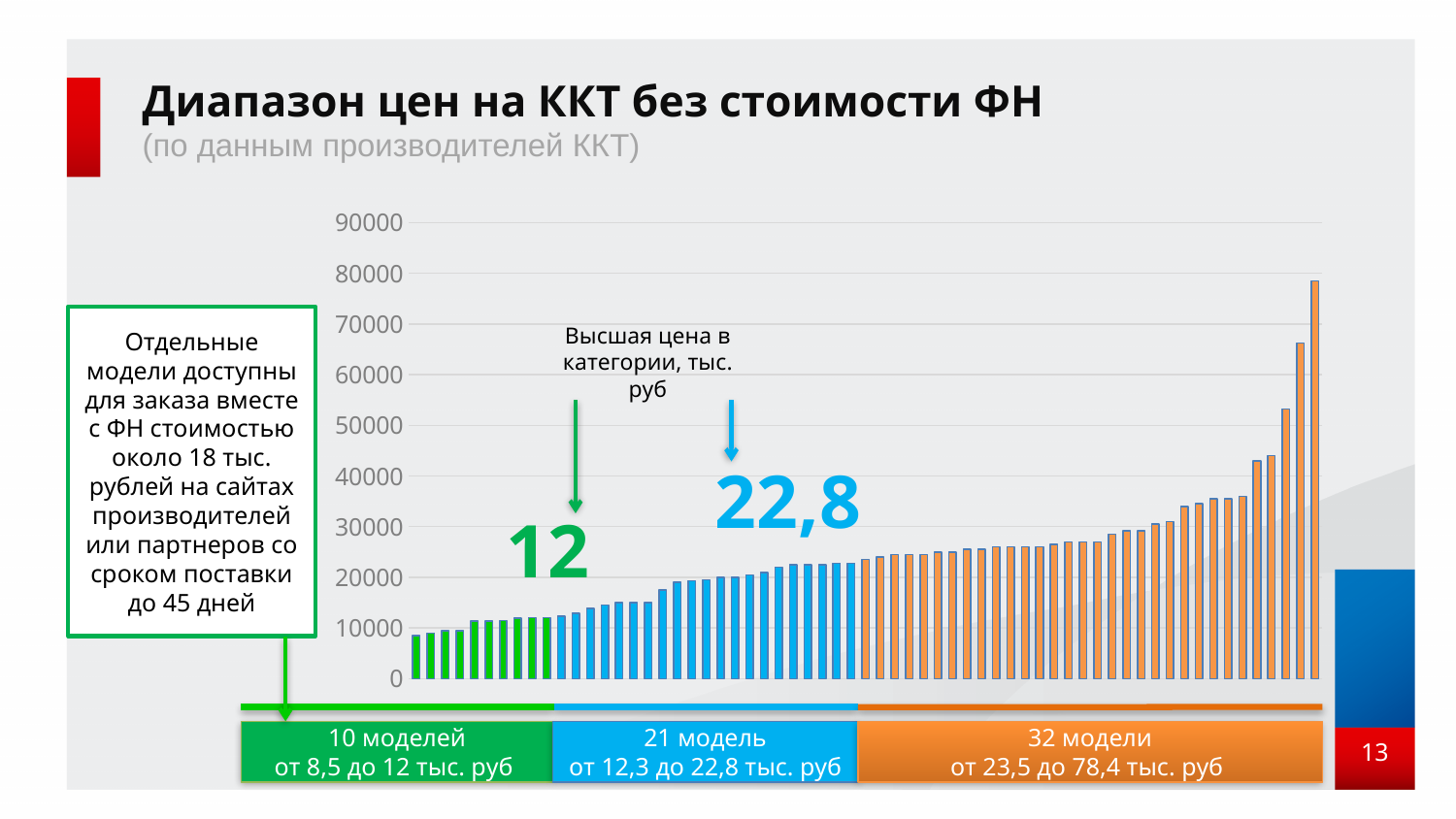
How many models are in the orange (highest-price) group? 32 модели What is the highest price in the green category, in thousand rubles? 12 Do the bar values rise or fall from left to right along the x axis? Rise What is the title of the chart on the slide? Диапазон цен на ККТ без стоимости ФН Is the value of the tallest bar greater or less than 70000? greater What kind of chart is shown on the slide? Bar chart How many models are in the green (lowest-price) group? 10 моделей How many more models are in the orange group than in the green group? 22 How many models are in the blue (middle-price) group? 21 модель Which group contains more models, the green group or the orange group? Orange group (32 модели) What is the highest price in the blue category, in thousand rubles? 22,8 What is the price range of the orange group of models? от 23,5 до 78,4 тыс. руб